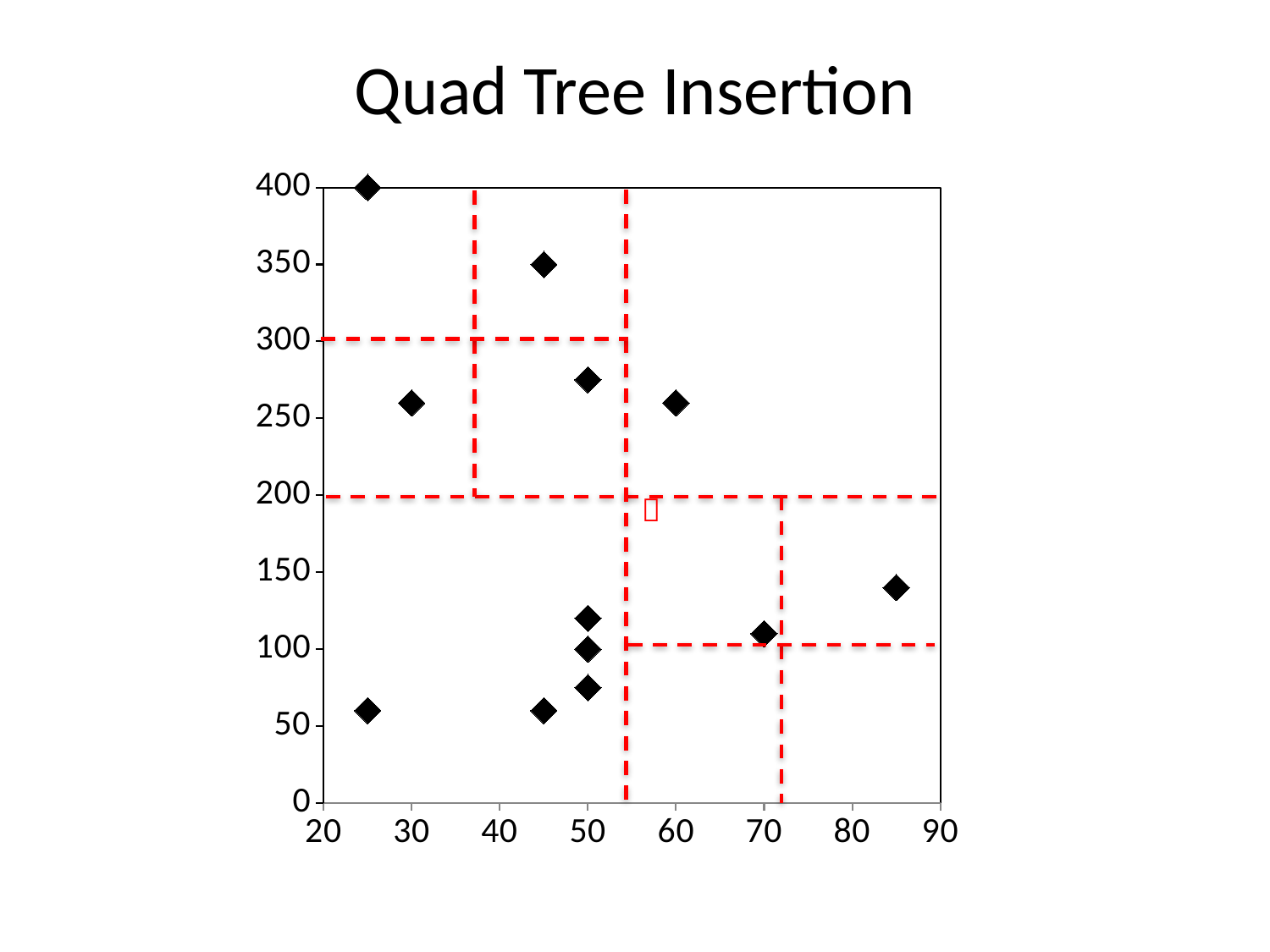
What colour are the dashed partition lines on the chart? red How many plotted points lie above the y value of 300? 2 What is the title of the chart? Quad Tree Insertion Is the y value of the lowest plotted points greater or less than 100? less What is the y value of the highest plotted point? 400 How many plotted points lie below the y value of 200? 7 Is the y value of the rightmost plotted point greater or less than 100? greater What is the largest value shown on the x axis? 90 How many data points are plotted on the chart? 12 Is the y value of the highest plotted point greater or less than 350? greater What kind of chart is shown on the slide? scatter chart